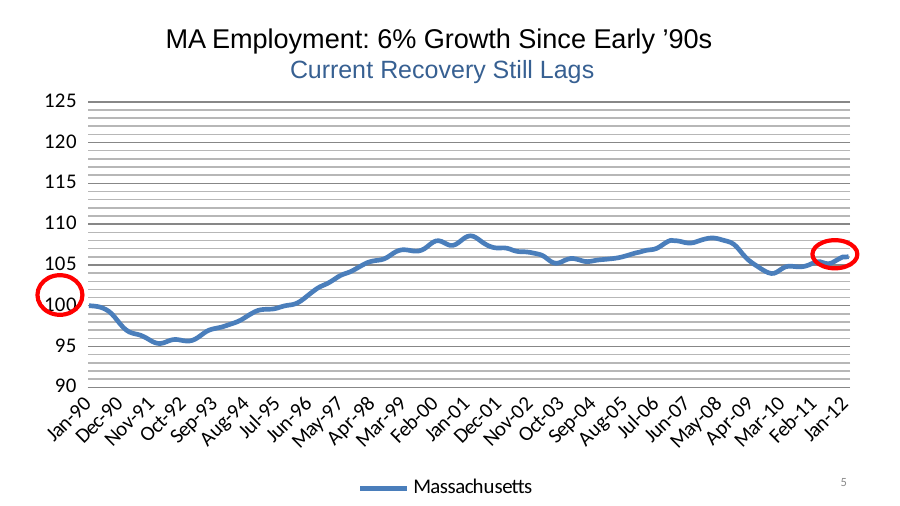
Does the line rise or fall between Nov-91 and Jan-01? rise What is the value of the Massachusetts line at Jan-90? 100 How many series does the legend list? 1 Which is larger, the value at Jan-90 or the value at Jan-12? Jan-12 What is the main title of the chart? MA Employment: 6% Growth Since Early '90s Does the line rise or fall between Jan-90 and Nov-91? fall What kind of chart is shown on the slide? line chart Is the value for Jan-12 greater or less than 105? greater Is the value for Jan-01 greater or less than 105? greater Is the value for Nov-91 greater or less than 100? less What is the name of the series shown in the legend? Massachusetts